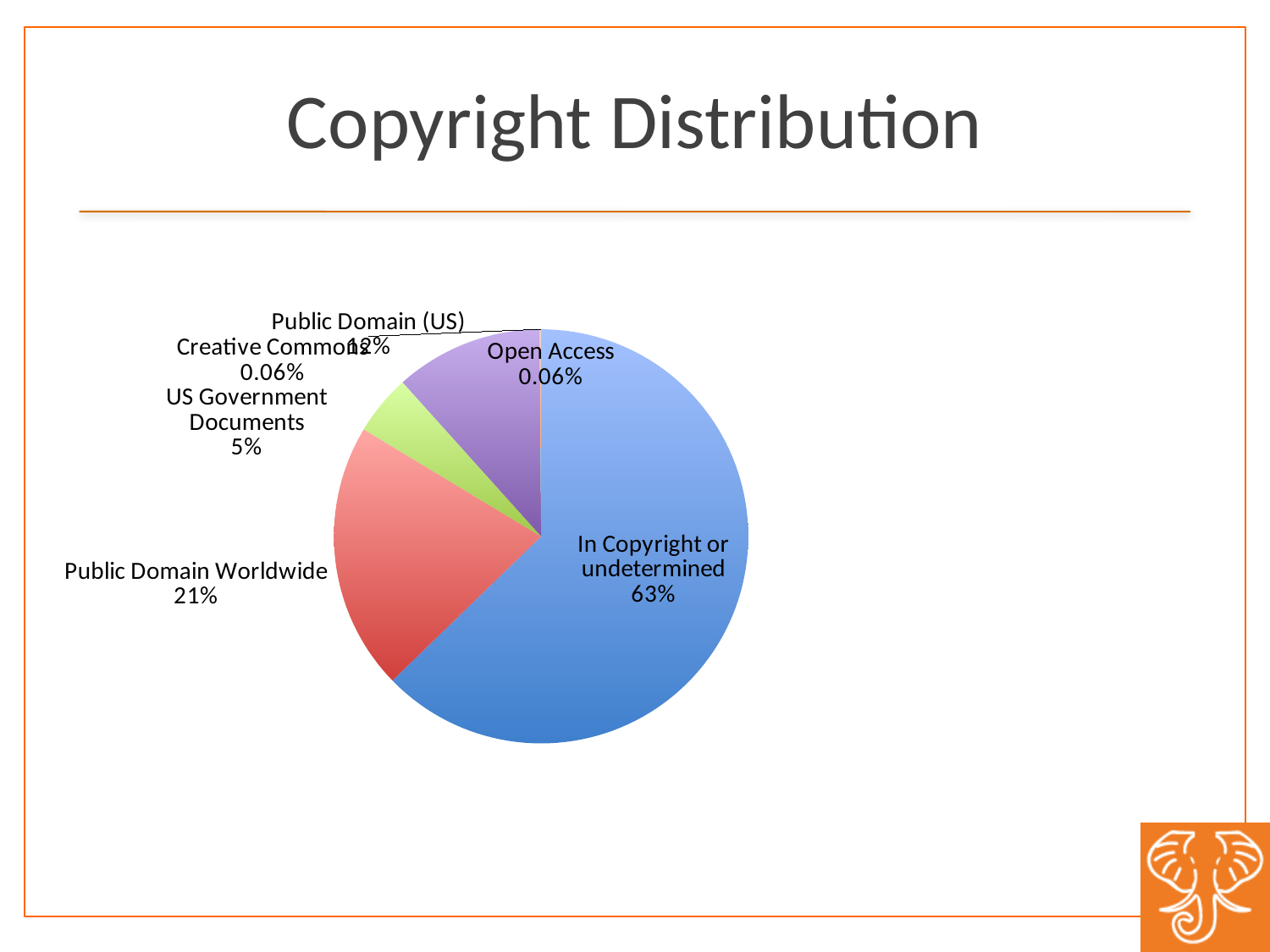
How many slices does the pie chart have? 6 What kind of chart is shown on the slide? Pie chart Which category has the largest slice of the pie? In Copyright or undetermined What share of the pie is labelled In Copyright or undetermined? 63% What colour is the In Copyright or undetermined slice? Blue What is the difference in percentage points between In Copyright or undetermined and Public Domain Worldwide? 42 percentage points What percentage is shown for Creative Commons? 0.06% What is the title of the chart? Copyright Distribution Which is larger, Public Domain Worldwide or US Government Documents? Public Domain Worldwide What percentage is shown for Public Domain Worldwide? 21% What percentage is shown for Open Access? 0.06% What percentage is shown for US Government Documents? 5%